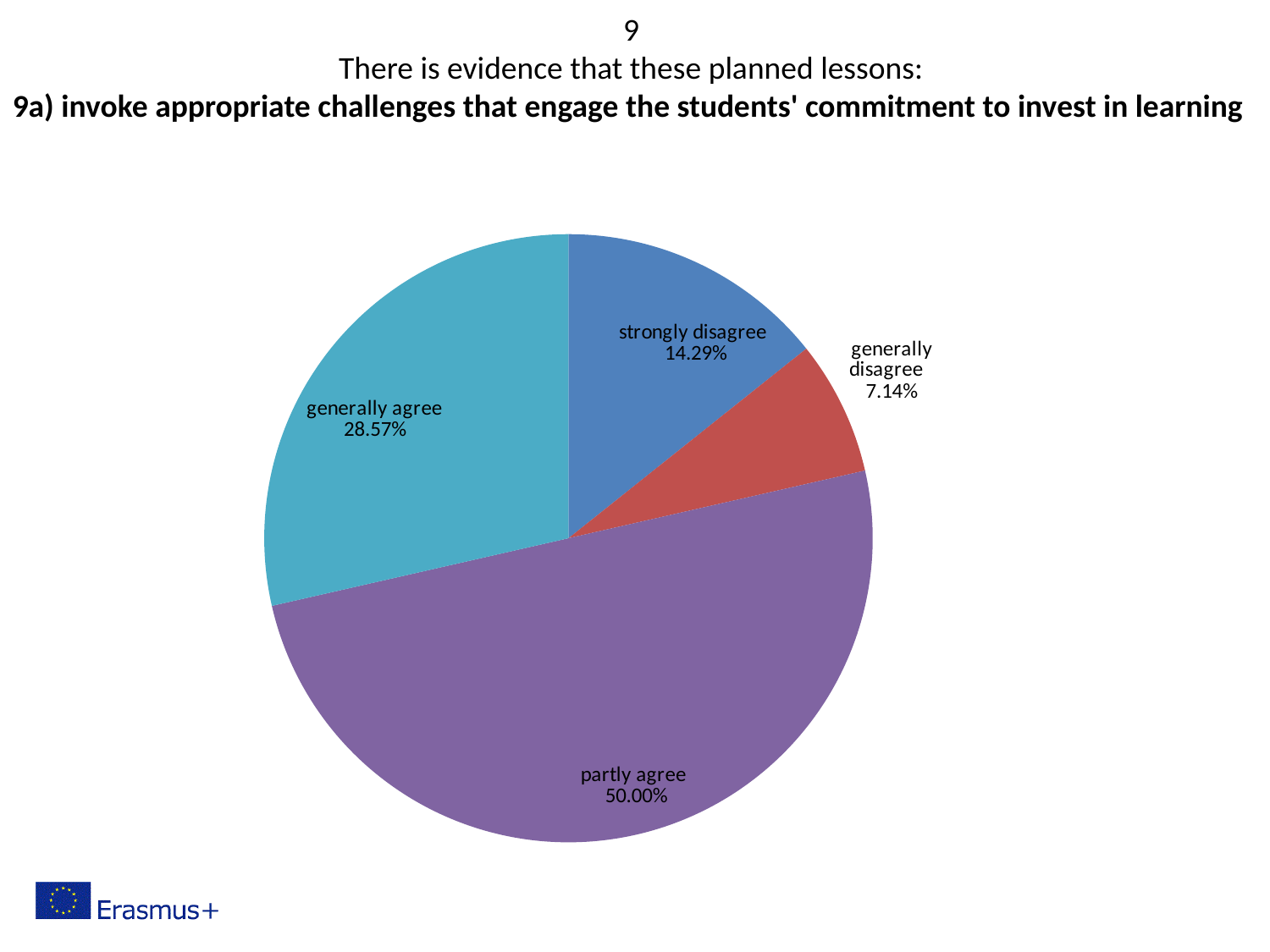
Which response category has the largest share of the pie? partly agree What kind of chart is shown on the slide? pie chart Which is larger, the share for 'strongly disagree' or the share for 'generally disagree'? strongly disagree What percentage of respondents chose 'partly agree'? 50.00% What is the difference in percentage points between 'generally agree' and 'strongly disagree'? 14.28 What percentage of respondents chose 'generally disagree'? 7.14% Which response category has the smallest share of the pie? generally disagree What is the combined share of 'strongly disagree' and 'generally disagree'? 21.43% How many slices does the pie chart have? 4 What percentage of respondents chose 'generally agree'? 28.57% What colour is the 'partly agree' slice? purple What percentage of respondents chose 'strongly disagree'? 14.29%